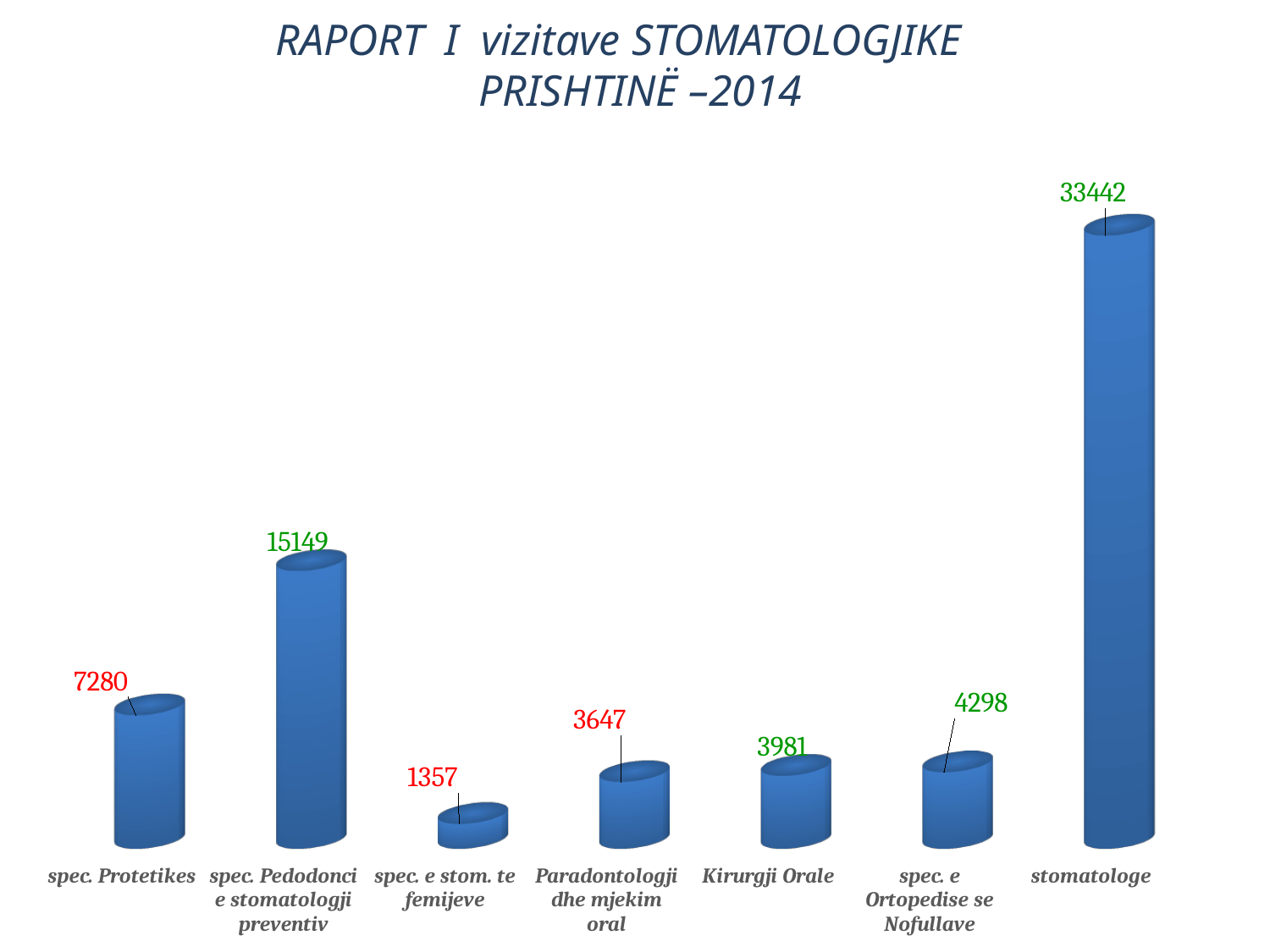
What is the value for Paradontologji dhe mjekim oral? 3647 Which category has the lowest value? spec. e stom. te femijeve What is the difference between the values for stomatologe and spec. Pedodonci e stomatologji preventiv? 18293 What is the value for spec. e Ortopedise se Nofullave? 4298 How many categories are shown in the chart? 7 Which is larger, the value for Kirurgji Orale or the value for Paradontologji dhe mjekim oral? Kirurgji Orale What is the difference between the values for spec. Protetikes and spec. e stom. te femijeve? 5923 Which category has the highest value? stomatologe What is the value for spec. Protetikes? 7280 What kind of chart is shown on the slide? Bar chart What is the value for stomatologe? 33442 What is the title of the chart? RAPORT I vizitave STOMATOLOGJIKE PRISHTINË –2014